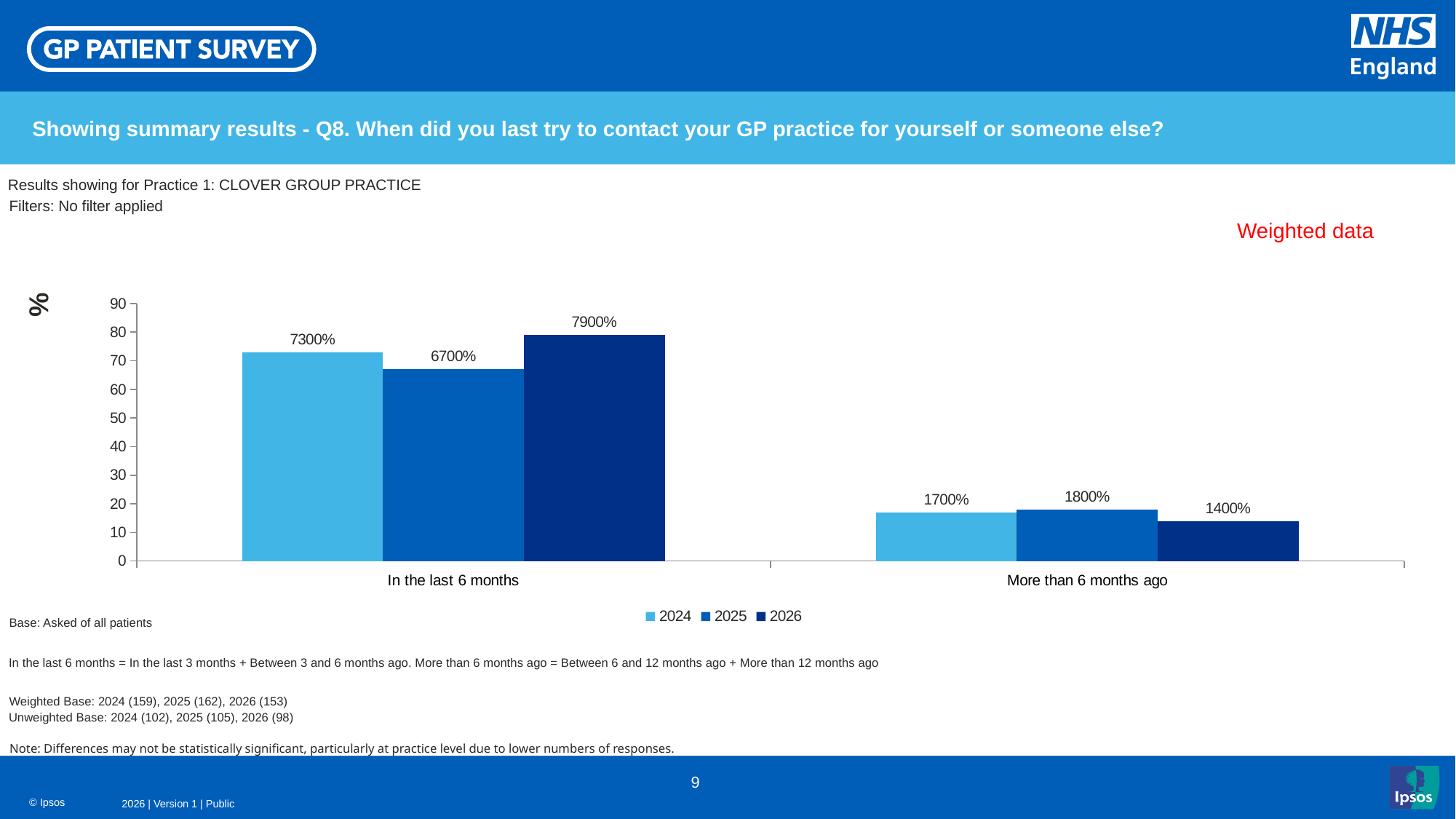
Which year has the lowest bar in the 'More than 6 months ago' category? 2026 How many categories are shown on the x axis? 2 What is the data label for 2026 in the 'More than 6 months ago' category? 1400% What kind of chart is shown on the slide? Bar chart What is the data label for 2024 in the 'In the last 6 months' category? 7300% What is the data label for 2026 in the 'In the last 6 months' category? 7900% What are the legend entries of the chart? 2024, 2025, 2026 Which year has the highest bar in the 'In the last 6 months' category? 2026 What is the data label for 2024 in the 'More than 6 months ago' category? 1700% How many series does the legend list? 3 In the 'More than 6 months ago' category, which is larger: the 2024 bar or the 2025 bar? 2025 What is the data label for 2025 in the 'In the last 6 months' category? 6700%